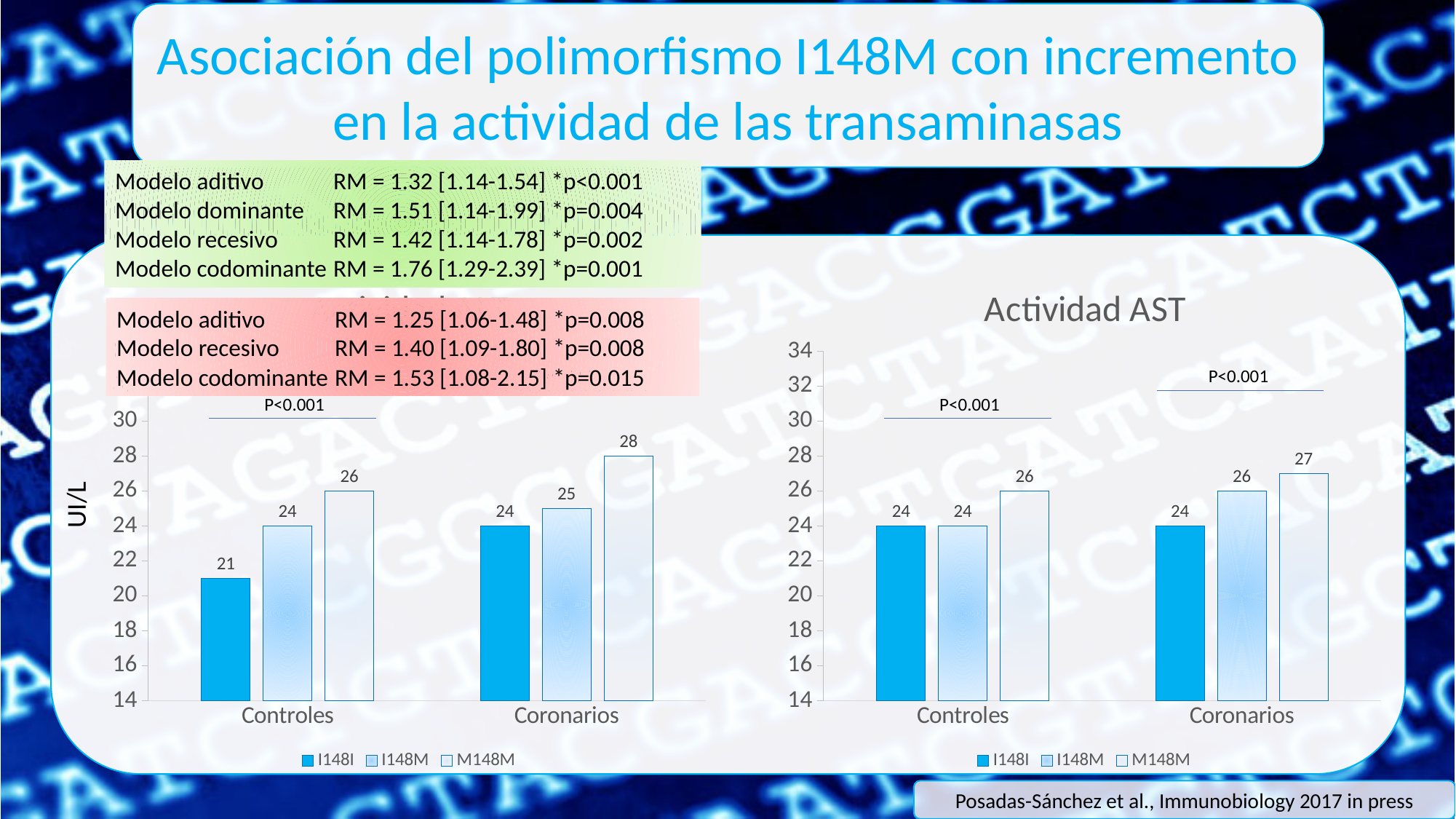
What is the y-axis label of the left chart? UI/L In the Actividad AST chart, what is the value for I148M in the Coronarios group? 26 In the Actividad AST chart, what is the difference between the M148M and I148I values in the Coronarios group? 3 How many series does the legend of the Actividad AST chart list? 3 In the Actividad AST chart, which is larger in the Coronarios group: I148M or M148M? M148M In the left chart, which series has the highest value in the Coronarios group? M148M In the left chart, what is the value for I148I in the Controles group? 21 In the left chart, what is the difference between the M148M and I148I values in the Controles group? 5 What kind of chart is the Actividad AST chart? Bar chart In the Actividad AST chart, what is the value for M148M in the Controles group? 26 In the left chart, what is the value for M148M in the Coronarios group? 28 In the left chart, which series has the lowest value in the Controles group? I148I